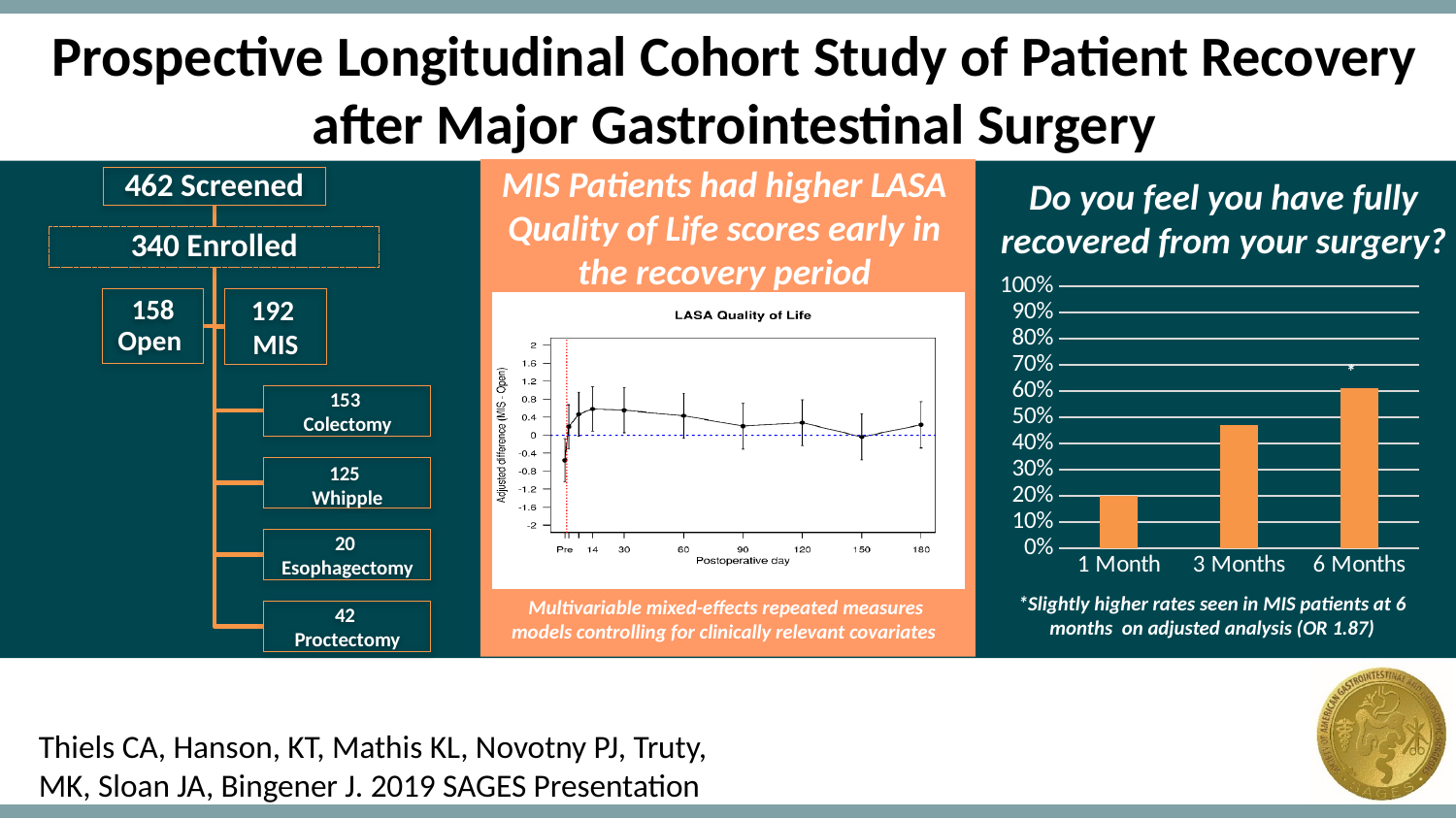
In the "LASA Quality of Life" chart, is the adjusted difference at the Pre time point greater or less than 0? less What kind of chart is the chart titled "Do you feel you have fully recovered from your surgery?"? bar chart In the chart "Do you feel you have fully recovered from your surgery?", how many time-point categories are shown on the x axis? 3 In the chart "Do you feel you have fully recovered from your surgery?", is the value for 3 Months greater or less than 40%? greater In the chart "Do you feel you have fully recovered from your surgery?", which is larger, the value for 3 Months or the value for 1 Month? 3 Months In the chart "Do you feel you have fully recovered from your surgery?", is the value for 1 Month greater or less than 30%? less What is the x-axis label of the "LASA Quality of Life" chart? Postoperative day In the chart "Do you feel you have fully recovered from your surgery?", which time point has the highest bar? 6 Months What kind of chart is the "LASA Quality of Life" chart in the middle of the slide? line chart In the chart "Do you feel you have fully recovered from your surgery?", which time point has the lowest bar? 1 Month In the chart "Do you feel you have fully recovered from your surgery?", do the values rise or fall from 1 Month to 6 Months? rise